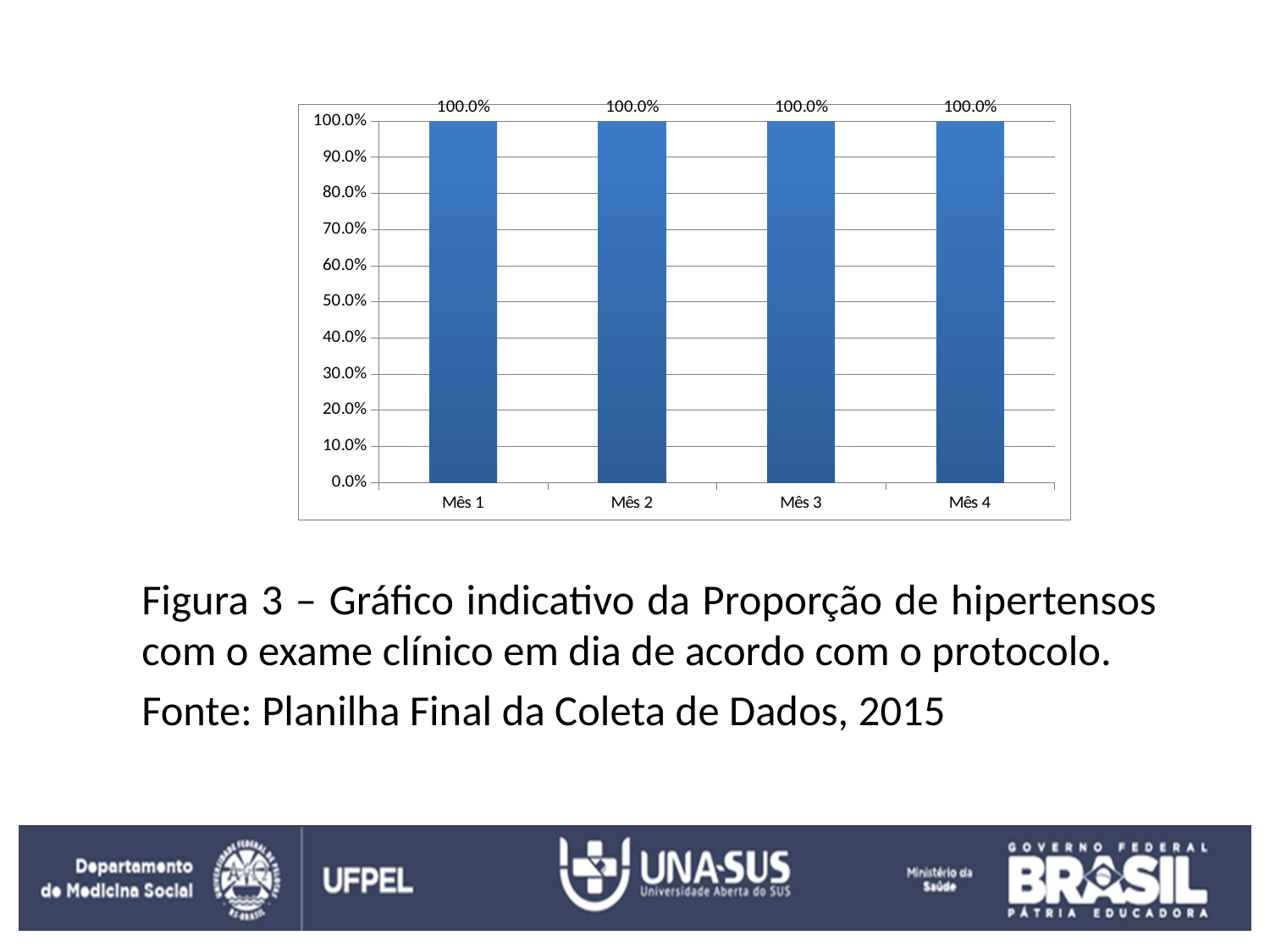
What is the highest value shown on the y axis of the chart? 100.0% What is the value for Mês 1? 100.0% What kind of chart is shown on the slide? Bar chart What is the difference between the values for Mês 1 and Mês 4? 0.0% What is the value for Mês 3? 100.0% According to the caption, what figure number is this chart? Figura 3 What is the value for Mês 2? 100.0% What is the value for Mês 4? 100.0% Do the values rise, fall, or stay the same from Mês 1 to Mês 4? Stay the same How many categories (months) are shown on the x axis of the chart? 4 Is the value for Mês 3 greater or less than 50.0%? greater